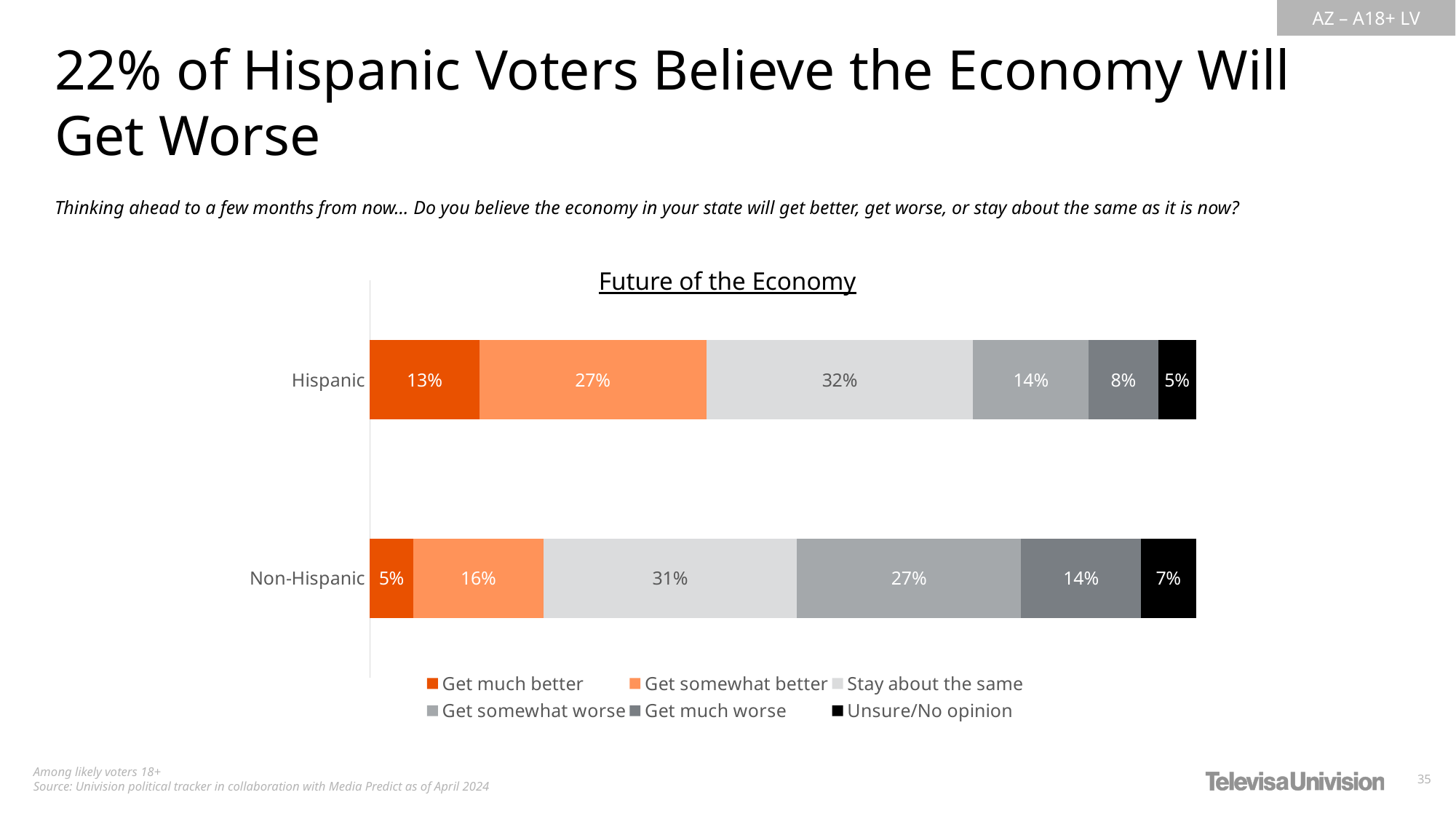
Which response category has the largest share among Hispanic voters? Stay about the same What percentage of Hispanic voters say the economy will stay about the same? 32% Which group has a larger share saying the economy will get much worse, Hispanic or Non-Hispanic? Non-Hispanic How many groups (bars) are shown in the chart? 2 What percentage of Hispanic voters say the economy will get much better? 13% What is the difference between the Hispanic and Non-Hispanic shares for 'Get somewhat better'? 11 percentage points What percentage of Non-Hispanic voters say the economy will get somewhat worse? 27% What percentage of Non-Hispanic voters are unsure or have no opinion? 7% What is the title of the chart? Future of the Economy Which response category has the smallest share among Non-Hispanic voters? Get much better How many series does the legend list? 6 What type of chart is shown on the slide? Stacked bar chart